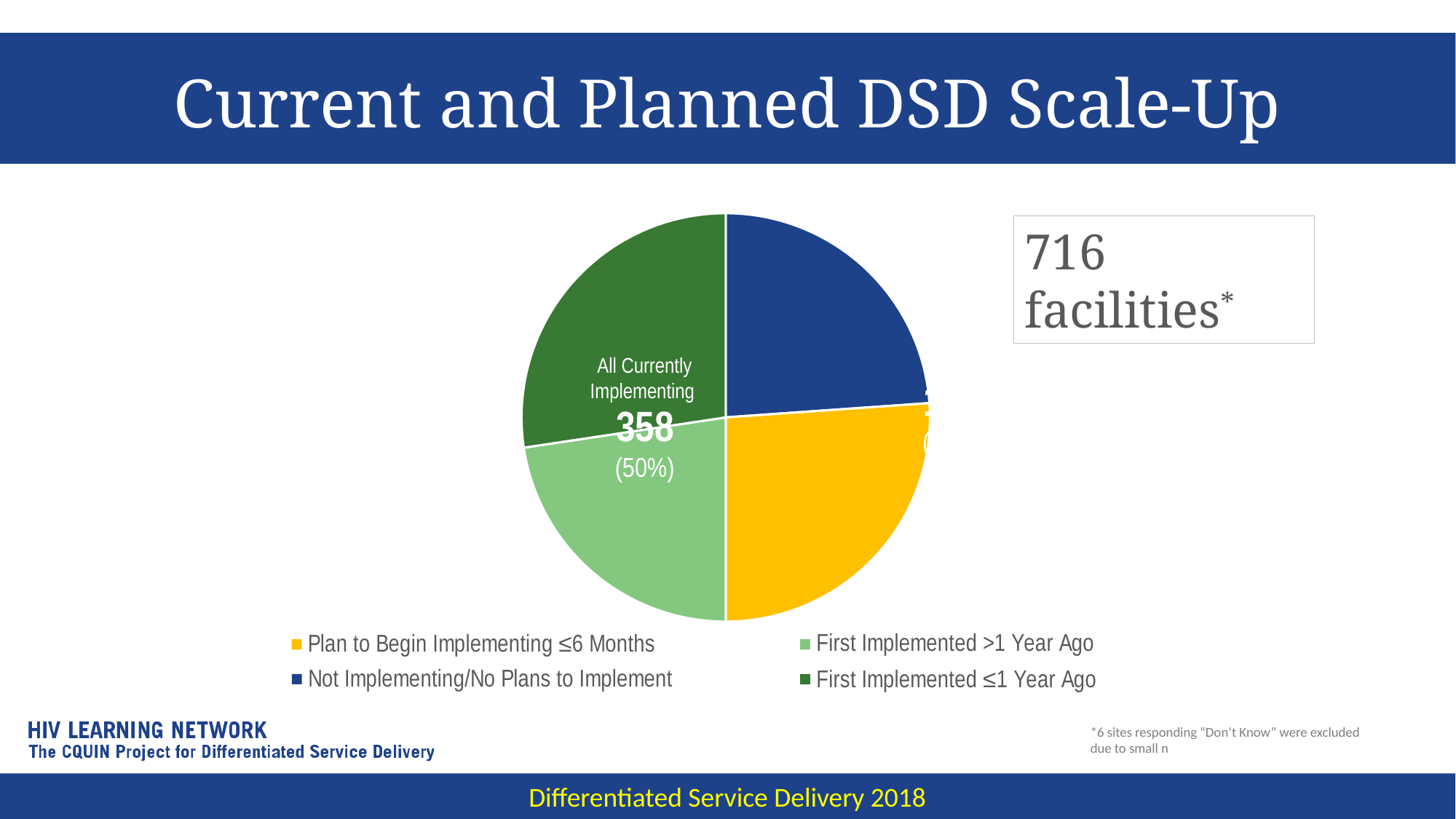
What kind of chart is shown on the slide? pie chart How many facilities are labelled as "All Currently Implementing" in the pie chart? 358 What share of the pie is labelled "All Currently Implementing"? 50% How many categories does the legend of the pie chart list? 4 How many facilities in total does the slide say the pie chart covers? 716 Which legend category is shown in dark blue in the pie chart? Not Implementing/No Plans to Implement Which two legend categories together make up the "All Currently Implementing" portion of the pie chart? First Implemented >1 Year Ago and First Implemented ≤1 Year Ago Which colour represents "Plan to Begin Implementing ≤6 Months" in the pie chart? yellow What is the title of the slide containing the pie chart? Current and Planned DSD Scale-Up